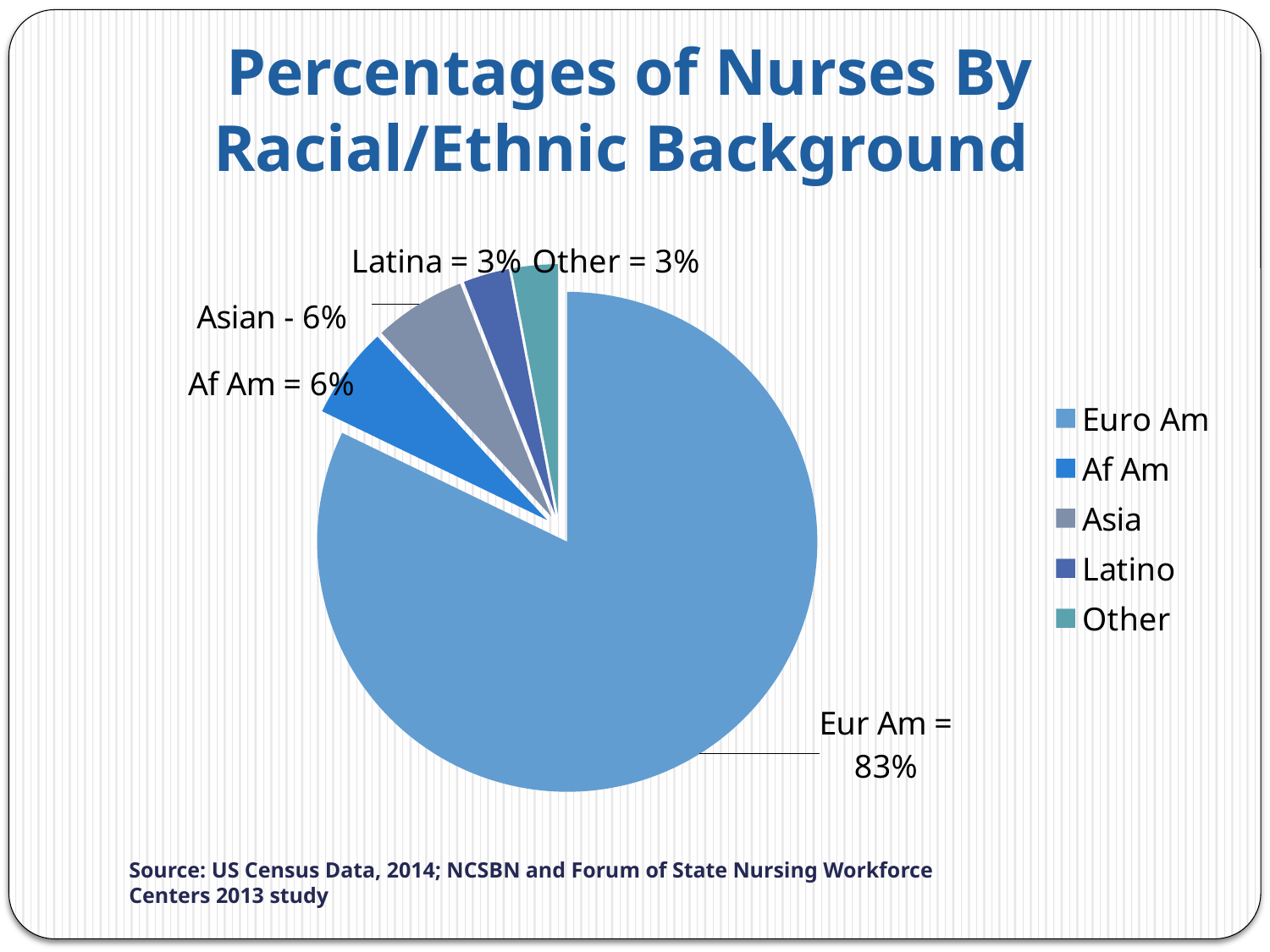
What percentage of nurses are Euro Am according to the pie chart? 83% What is the title of the chart? Percentages of Nurses By Racial/Ethnic Background What percentage of nurses are Asian? 6% How many entries does the legend list? 5 What type of chart is shown on the slide? Pie chart What percentage of nurses fall under Other? 3% Which racial/ethnic group has the largest share of nurses? Euro Am Which is larger, the Af Am share or the Latina share? Af Am What percentage of nurses are Latina? 3% How many slices does the pie chart have? 5 What percentage of nurses are Af Am? 6% What is the difference in percentage points between the Euro Am share and the Af Am share? 77